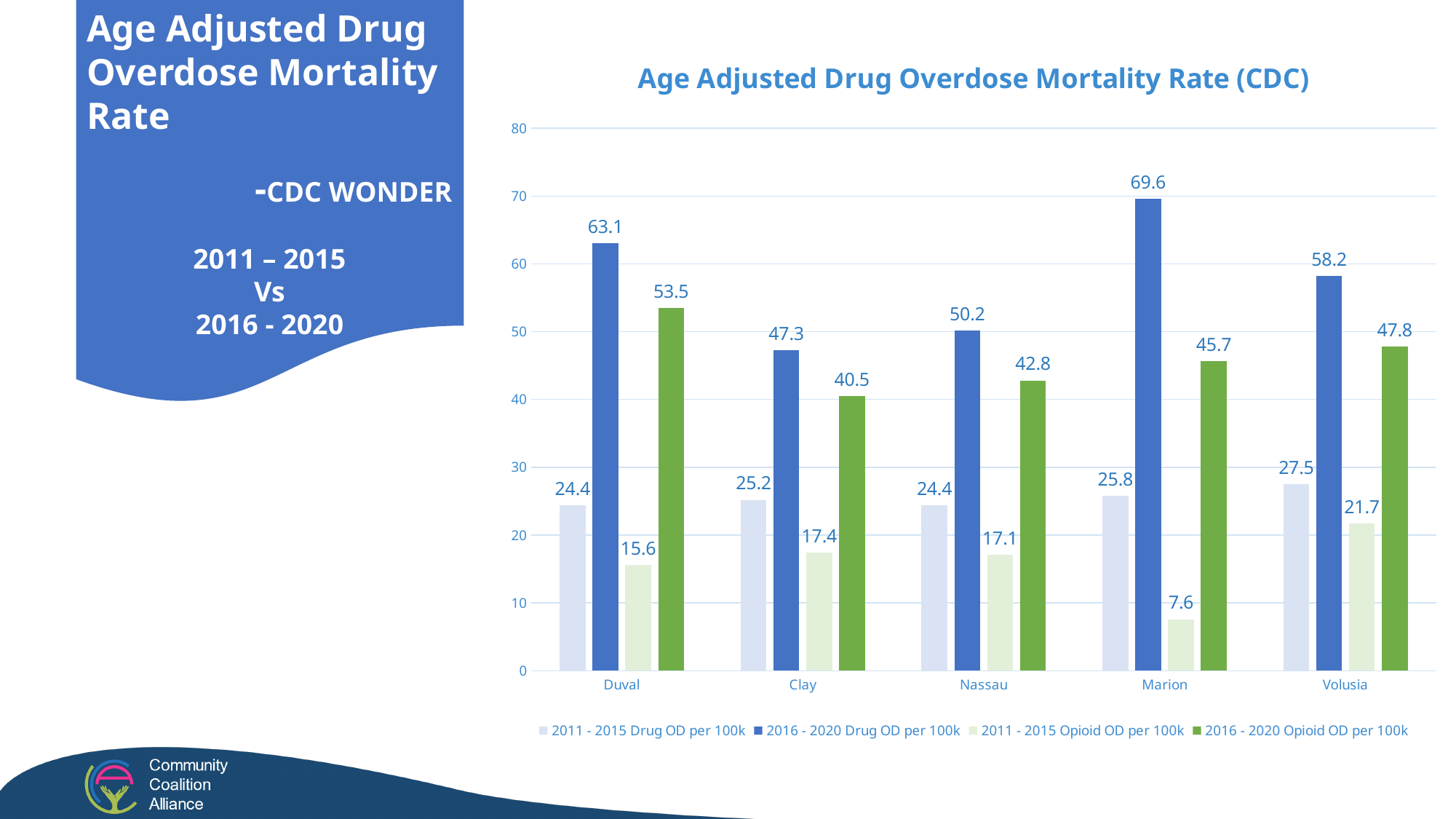
Which county has the lowest 2011 - 2015 Opioid OD per 100k value? Marion Which is larger: the 2016 - 2020 Opioid OD per 100k value for Clay or for Nassau? Nassau What is the difference between the 2016 - 2020 Drug OD per 100k and the 2011 - 2015 Drug OD per 100k values for Duval? 38.7 What is the 2016 - 2020 Drug OD per 100k value for Marion? 69.6 Which county has the highest 2016 - 2020 Drug OD per 100k value? Marion What is the 2016 - 2020 Opioid OD per 100k value for Duval? 53.5 What kind of chart is shown on the slide? Bar chart How many series does the legend list? 4 How many counties are shown on the x axis? 5 Is the 2016 - 2020 Drug OD per 100k value for Volusia greater or less than 50? greater What is the 2011 - 2015 Opioid OD per 100k value for Volusia? 21.7 What is the title of the chart? Age Adjusted Drug Overdose Mortality Rate (CDC)